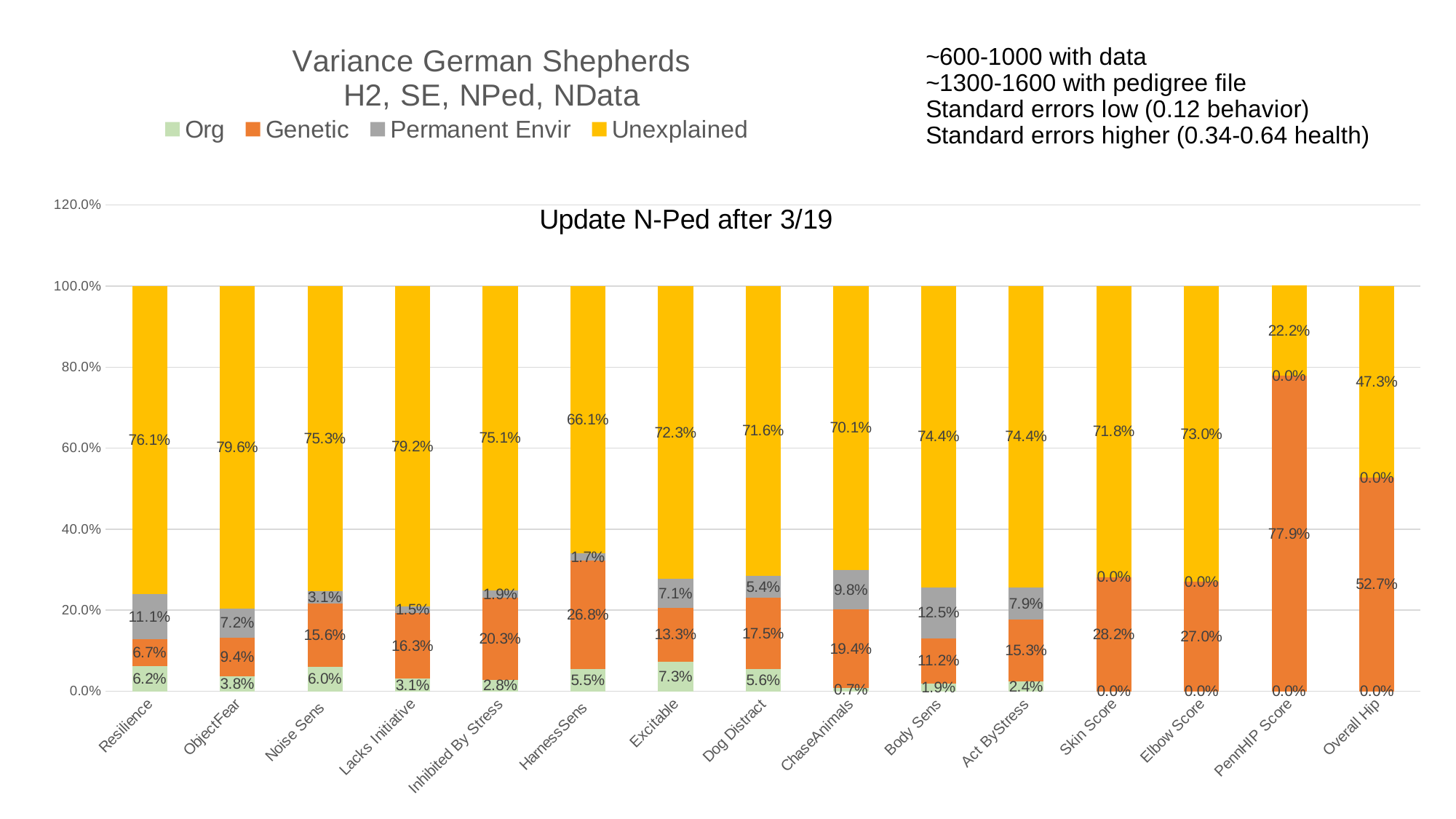
What is the difference between the Genetic values for Skin Score and Elbow Score? 1.2% What kind of chart is shown on the slide? Stacked bar chart What is the Permanent Envir value for Body Sens? 12.5% Which category has the lowest Unexplained value? PennHIP Score What is the total of the stacked bar for ObjectFear? 100.0% Which is larger, the Genetic value for Overall Hip or the Unexplained value for Overall Hip? Genetic (52.7%) How many categories are shown on the x axis? 15 What is the Unexplained value for Resilience? 76.1% What is the Org value for Excitable? 7.3% Which category has the highest Genetic value? PennHIP Score How many series does the legend list? 4 What is the Genetic value for HarnessSens? 26.8%